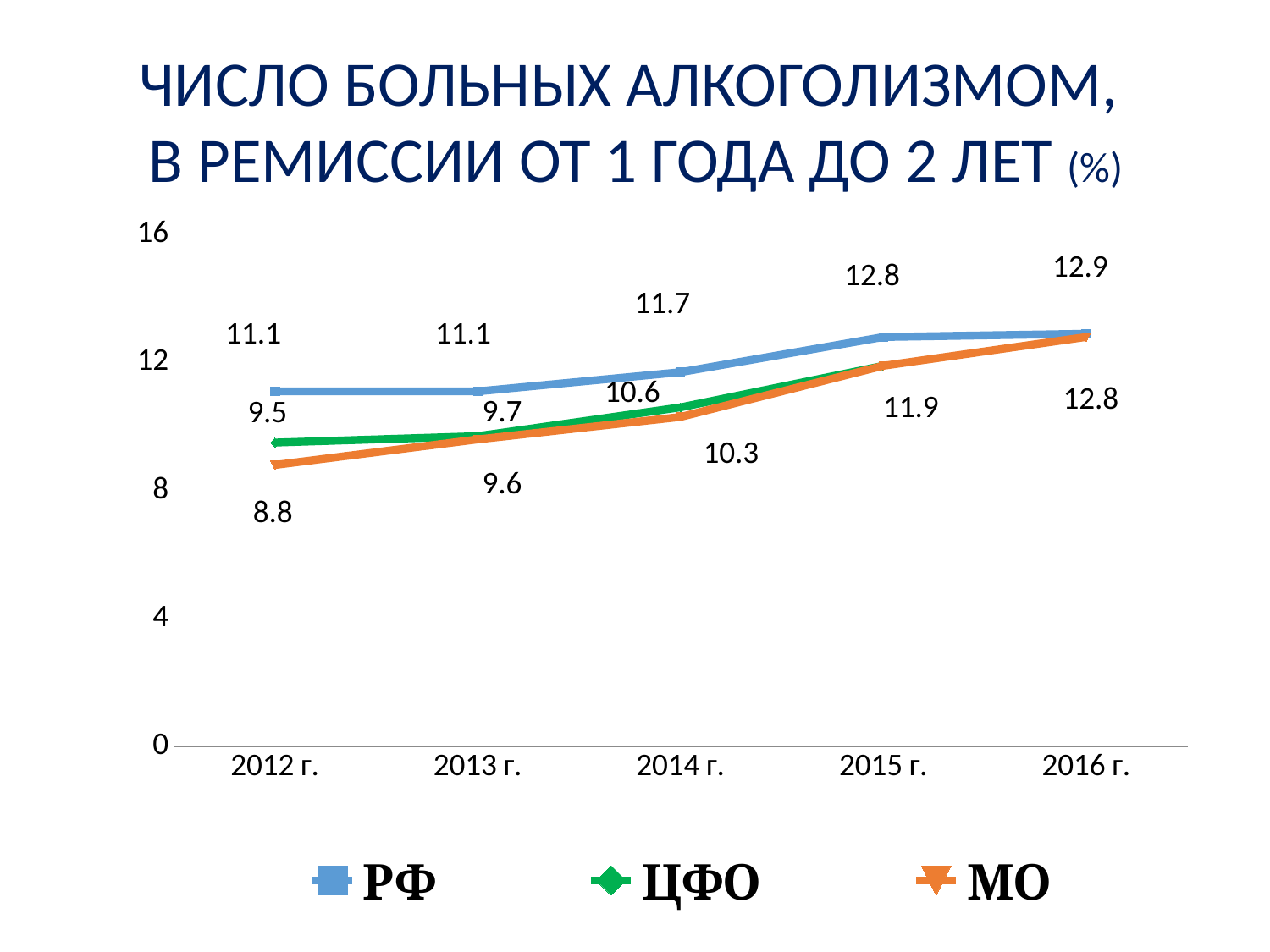
How many series does the legend list? 3 What kind of chart is shown on the slide? line chart What is the value for РФ in 2012 г.? 11.1 What is the value for МО in 2012 г.? 8.8 In which year does the МО series reach its highest value? 2016 г. What is the value for МО in 2016 г.? 12.8 What is the difference between the РФ and МО values in 2012 г.? 2.3 How many years are shown on the x axis? 5 In which year does the РФ series reach its lowest value? 2012 г. and 2013 г. (11.1) Which series has the larger value in 2014 г., РФ or МО? РФ Is the value for ЦФО in 2015 г. greater or less than 8? greater What is the value for ЦФО in 2014 г.? 10.6